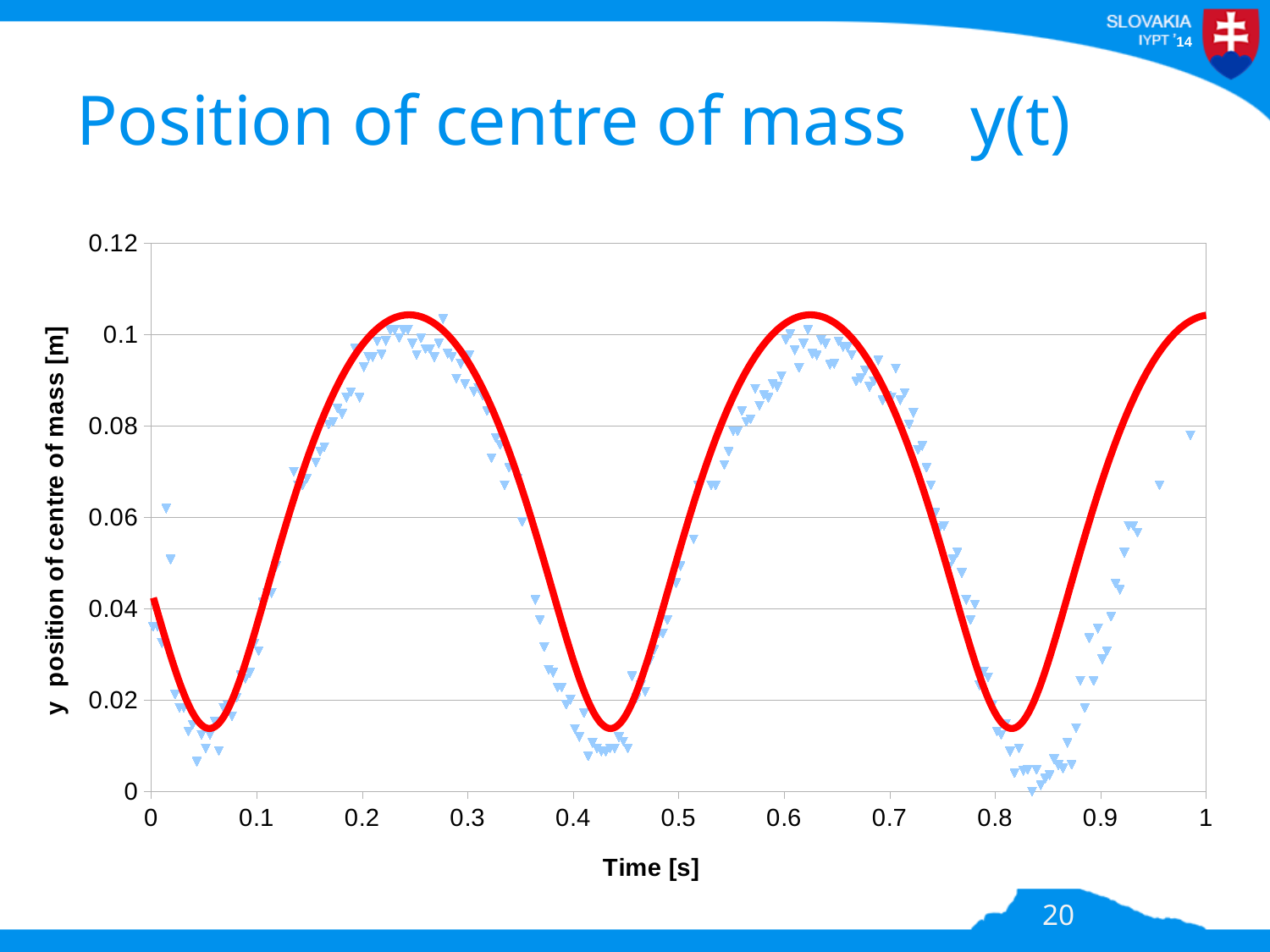
Is the value of the red curve at time 0.25 s greater or less than 0.1? greater How many minima does the red curve have between time 0 and 1 s? 3 What kind of chart is shown on the slide? Scatter plot with a fitted line Is the value of the red curve at time 0.2 s greater or less than 0.08? greater What is the label of the y axis? y position of centre of mass [m] Is the value of the red curve at time 1 s greater or less than 0.1? greater What is the label of the x axis? Time [s] Does the red curve rise or fall between time 0.3 s and 0.4 s? fall Does the red curve rise or fall between time 0.1 s and 0.2 s? rise